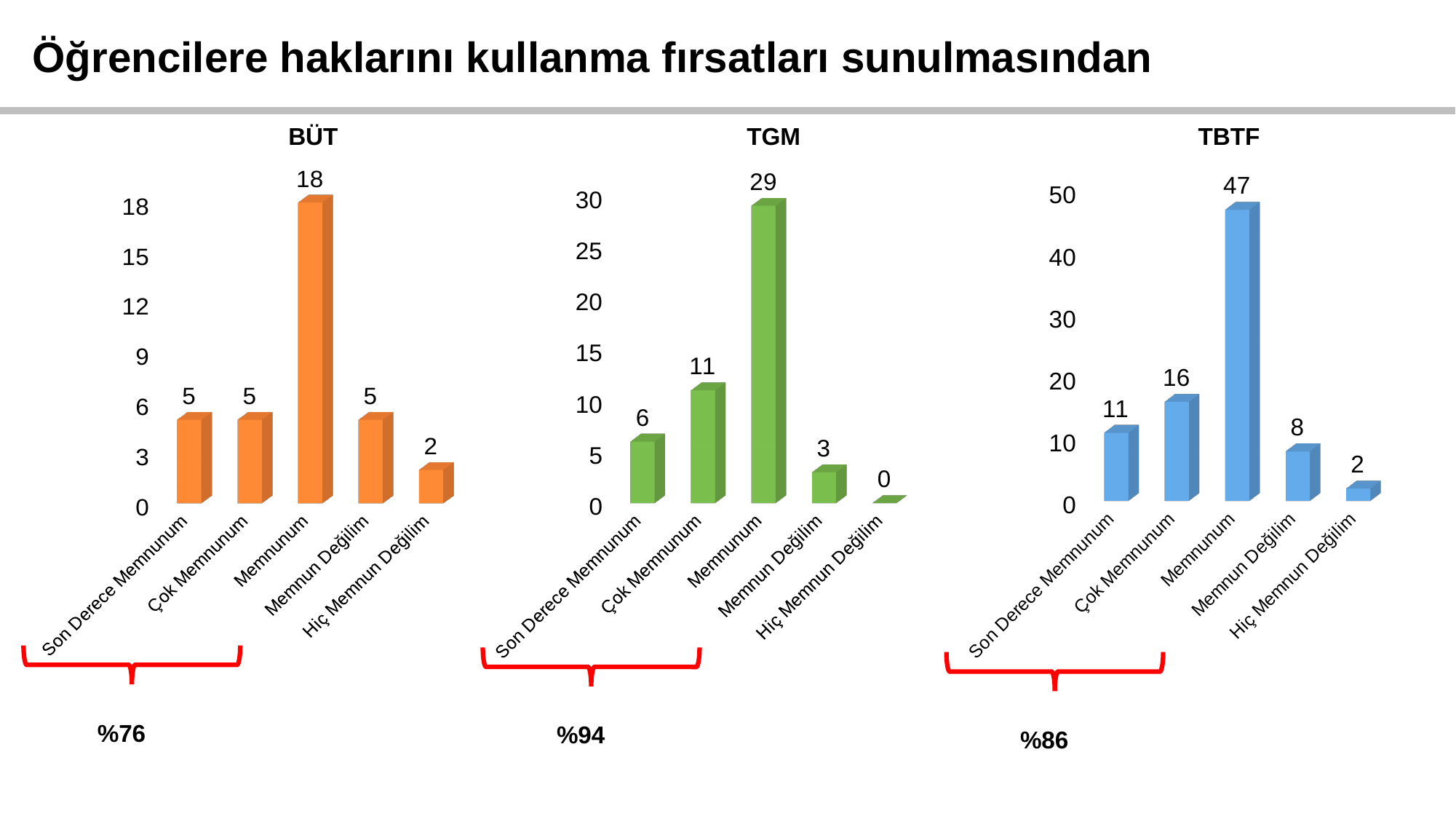
In the TGM chart, which category has the highest value? Memnunum In the TGM chart, what is the value for Hiç Memnun Değilim? 0 In the TBTF chart, what is the value for Memnun Değilim? 8 What colour are the bars in the BÜT chart? orange In the TGM chart, what is the value for Çok Memnunum? 11 What percentage is shown below the TBTF chart? %86 What kind of chart is the TGM chart? bar chart How many categories does the BÜT chart show? 5 In the BÜT chart, what is the value for Memnunum? 18 In the TBTF chart, which category has the lowest value? Hiç Memnun Değilim In the TGM chart, which is larger: Son Derece Memnunum or Çok Memnunum? Çok Memnunum In the TBTF chart, what is the difference between Memnunum and Çok Memnunum? 31